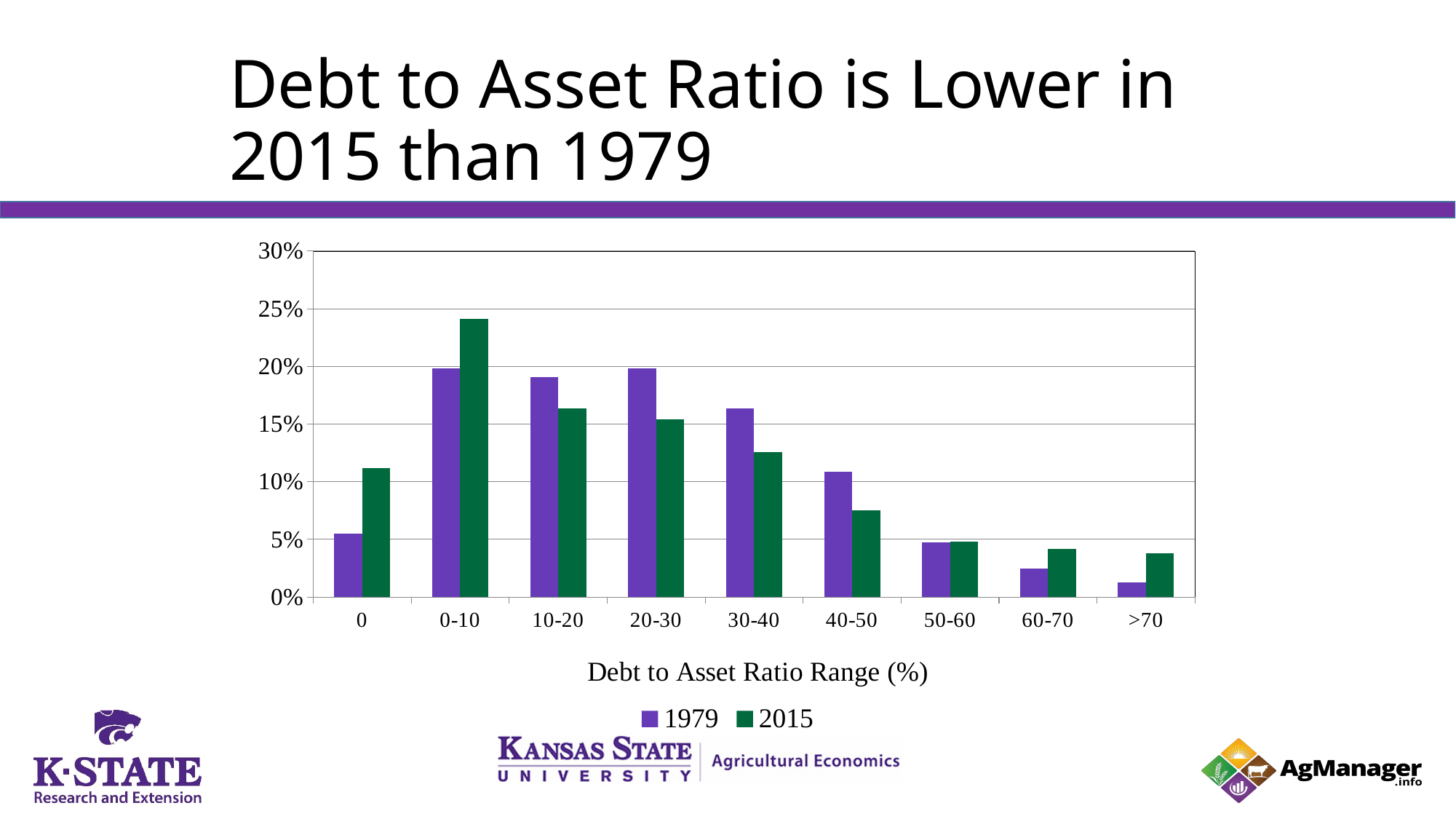
Is the 2015 value for the 0-10 range greater or less than 20%? greater For the 20-30 range, which series has the larger value, 1979 or 2015? 1979 Which debt to asset ratio range has the highest value for 2015? 0-10 What is the x axis title of the chart? Debt to Asset Ratio Range (%) How many series does the legend list? 2 Is the 2015 value for the 30-40 range greater or less than 15%? less What kind of chart is shown on the slide? bar chart Is the 1979 value for the 40-50 range greater or less than 10%? greater Which debt to asset ratio range has the lowest value for 1979? >70 How many debt to asset ratio range categories are shown on the x axis? 9 For the 60-70 range, which series has the larger value, 1979 or 2015? 2015